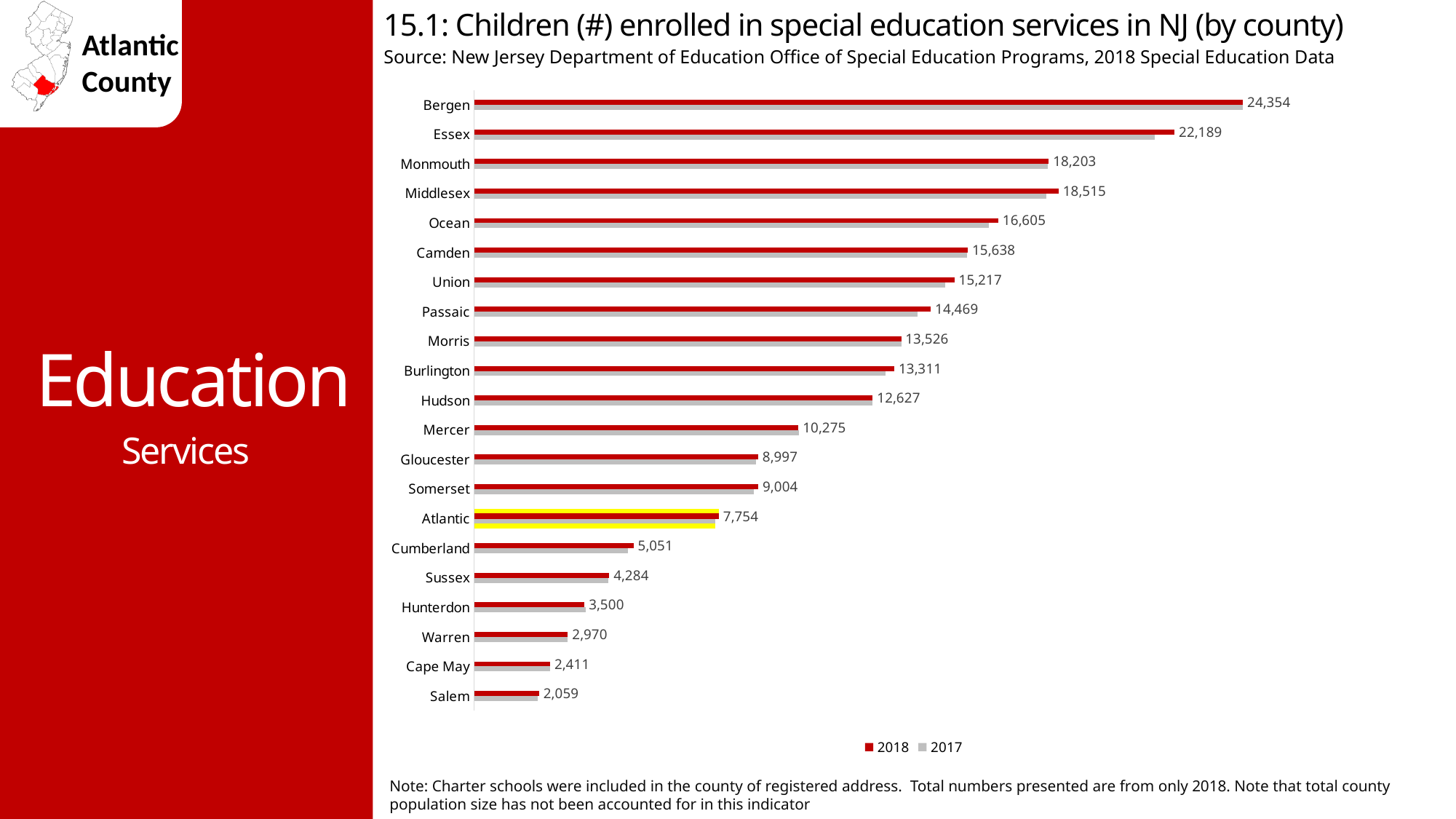
Which county has the lowest number of children enrolled in special education services in 2018? Salem How many counties are shown on the chart? 21 What kind of chart is shown on the slide? Bar chart What is the 2018 value for Atlantic county? 7,754 How many children were enrolled in special education services in Bergen county in 2018? 24,354 Which county has the highest number of children enrolled in special education services in 2018? Bergen What is the 2018 value shown for Cumberland county? 5,051 Which county had more children enrolled in 2018, Middlesex or Monmouth? Middlesex Which county had more children enrolled in 2018, Somerset or Gloucester? Somerset How many series does the legend list? 2 What is the difference between the 2018 values for Atlantic and Cumberland? 2,703 What is the difference between the 2018 values for Bergen and Essex? 2,165